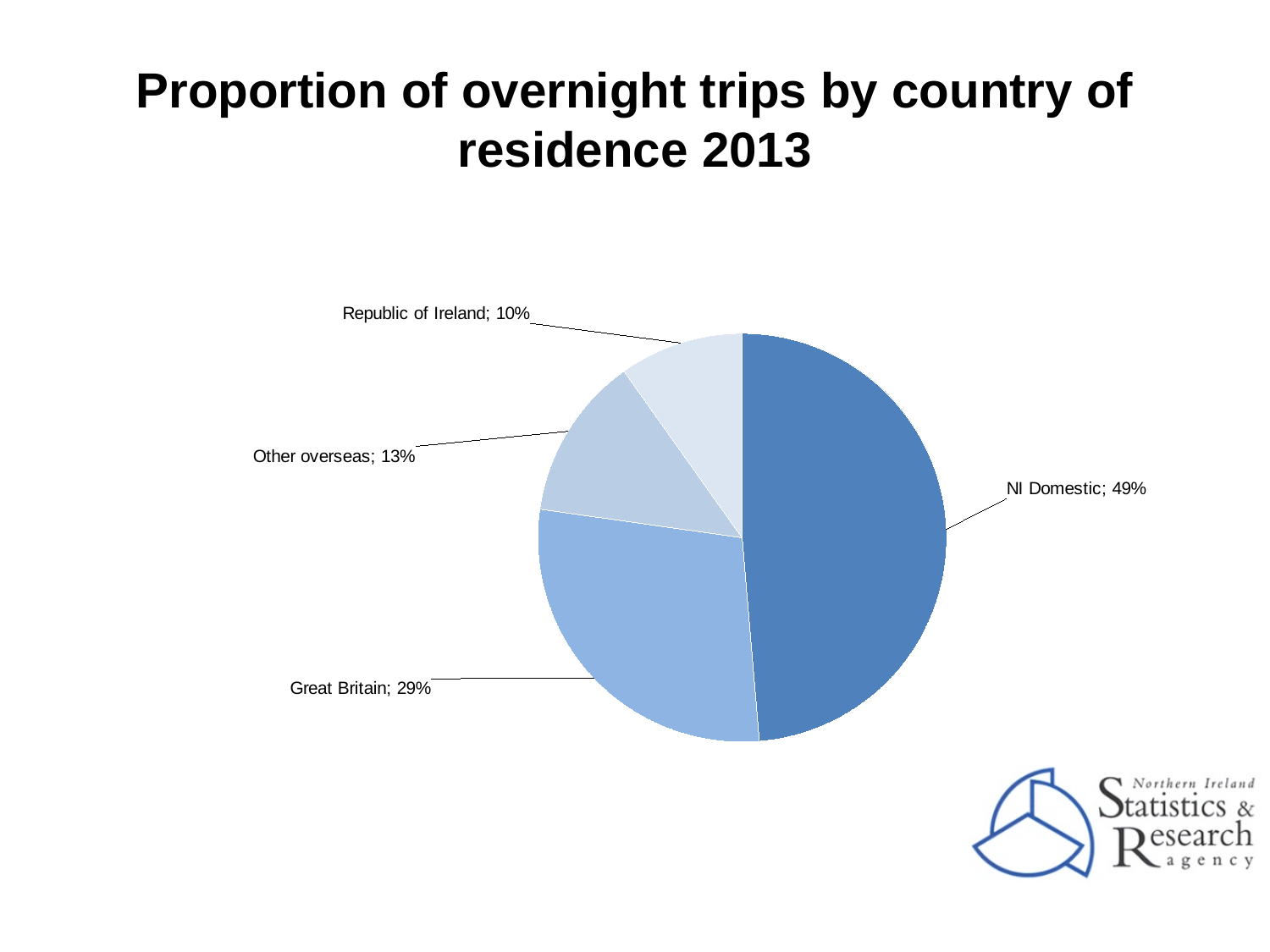
How many slices does the pie chart have? 4 What share of overnight trips is from Great Britain? 29% What share of overnight trips is from Other overseas? 13% What is the title of the chart? Proportion of overnight trips by country of residence 2013 Which country of residence has the largest share of overnight trips? NI Domestic What is the difference in percentage points between Other overseas and Republic of Ireland? 3 What share of overnight trips is from NI Domestic? 49% Which country of residence has the smallest share of overnight trips? Republic of Ireland What is the difference in percentage points between NI Domestic and Great Britain? 20 What share of overnight trips is from the Republic of Ireland? 10% Which has a larger share of overnight trips, Other overseas or Republic of Ireland? Other overseas What type of chart is shown on the slide? Pie chart